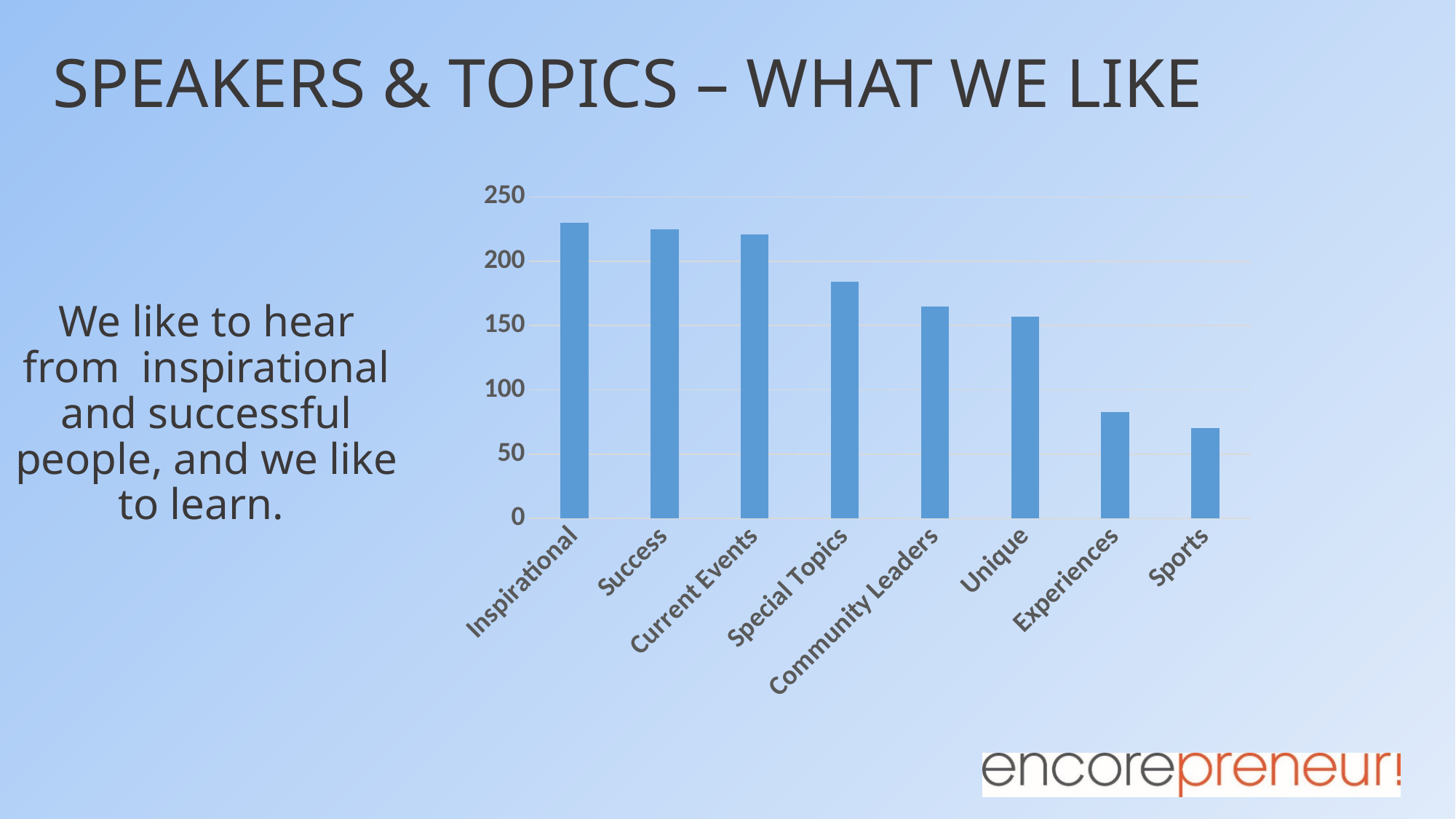
What is the highest value shown on the chart's vertical axis? 250 Is the value for Sports greater or less than 100? less Which category has the lowest value in the chart? Sports Which has a larger value, Special Topics or Experiences? Special Topics Is the value for Experiences greater or less than 100? less How many categories are shown on the x axis of the chart? 8 Is the value for Community Leaders greater or less than 150? greater Which has a larger value, Current Events or Unique? Current Events Do the bar values rise or fall from left to right along the x axis? fall What kind of chart is shown on the slide? bar chart